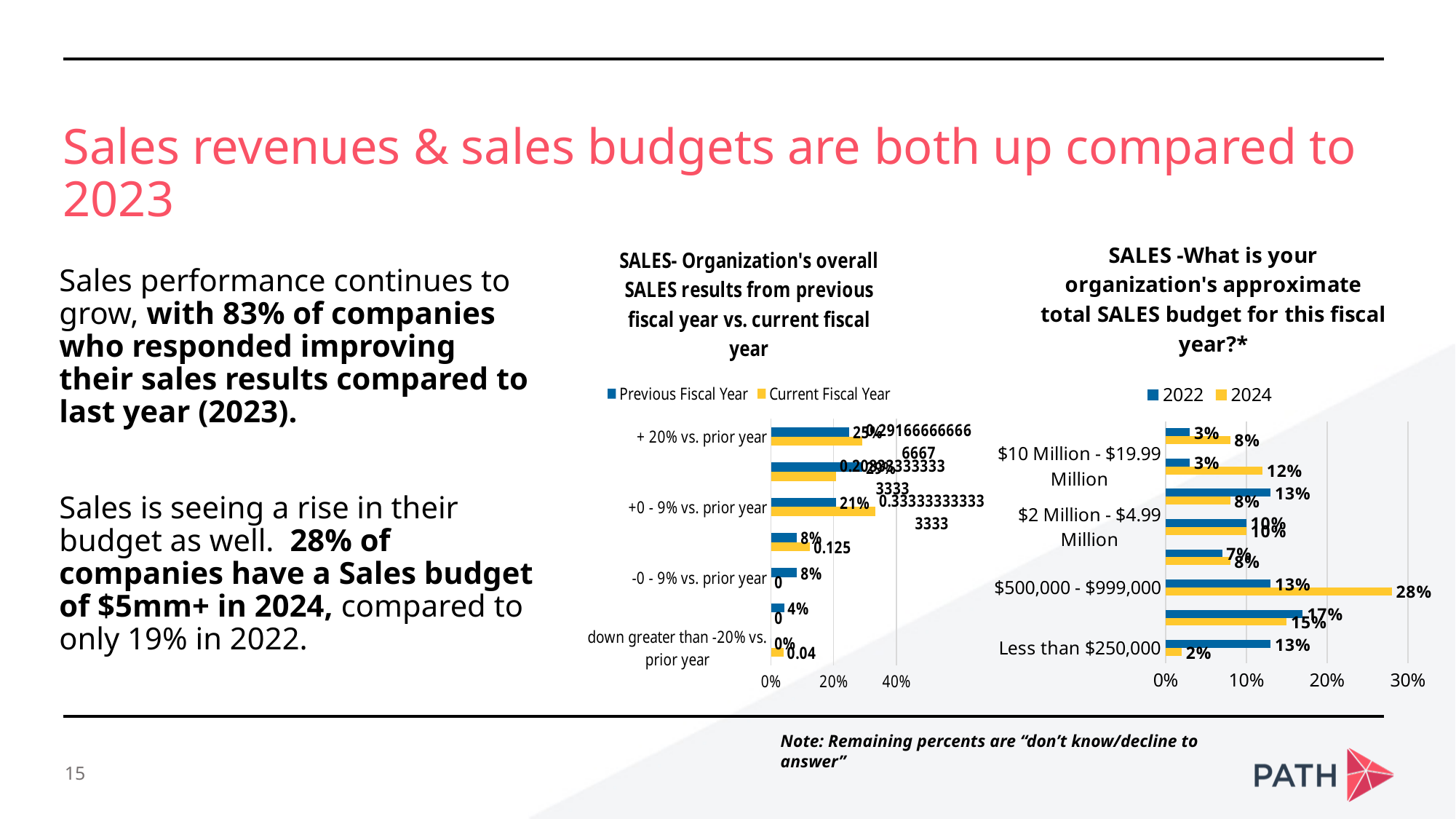
What are the two legend entries in the chart titled "SALES- Organization's overall SALES results from previous fiscal year vs. current fiscal year"? Previous Fiscal Year and Current Fiscal Year How many series does the legend list in the chart titled "SALES -What is your organization's approximate total SALES budget for this fiscal year?*"? 2 In the chart titled "SALES -What is your organization's approximate total SALES budget for this fiscal year?*", which is larger for Less than $250,000: the 2022 value or the 2024 value? 2022 In the chart titled "SALES -What is your organization's approximate total SALES budget for this fiscal year?*", what is the 2022 value for Less than $250,000? 13% In the chart titled "SALES- Organization's overall SALES results from previous fiscal year vs. current fiscal year", is the Current Fiscal Year value for "+0 - 9% vs. prior year" greater or less than 20%? greater In the chart titled "SALES -What is your organization's approximate total SALES budget for this fiscal year?*", what is the 2024 value for $10 Million - $19.99 Million? 12% In the chart titled "SALES -What is your organization's approximate total SALES budget for this fiscal year?*", what is the 2024 value for $500,000 - $999,000? 28% In the chart titled "SALES- Organization's overall SALES results from previous fiscal year vs. current fiscal year", what is the Previous Fiscal Year value for "+ 20% vs. prior year"? 25% In the chart titled "SALES -What is your organization's approximate total SALES budget for this fiscal year?*", what is the difference between the 2024 and 2022 values for $500,000 - $999,000? 15% In the chart titled "SALES- Organization's overall SALES results from previous fiscal year vs. current fiscal year", what is the Previous Fiscal Year value for "+0 - 9% vs. prior year"? 21% In the chart titled "SALES -What is your organization's approximate total SALES budget for this fiscal year?*", which category has the highest 2024 value? $500,000 - $999,000 What kind of chart is the chart titled "SALES -What is your organization's approximate total SALES budget for this fiscal year?*"? Bar chart